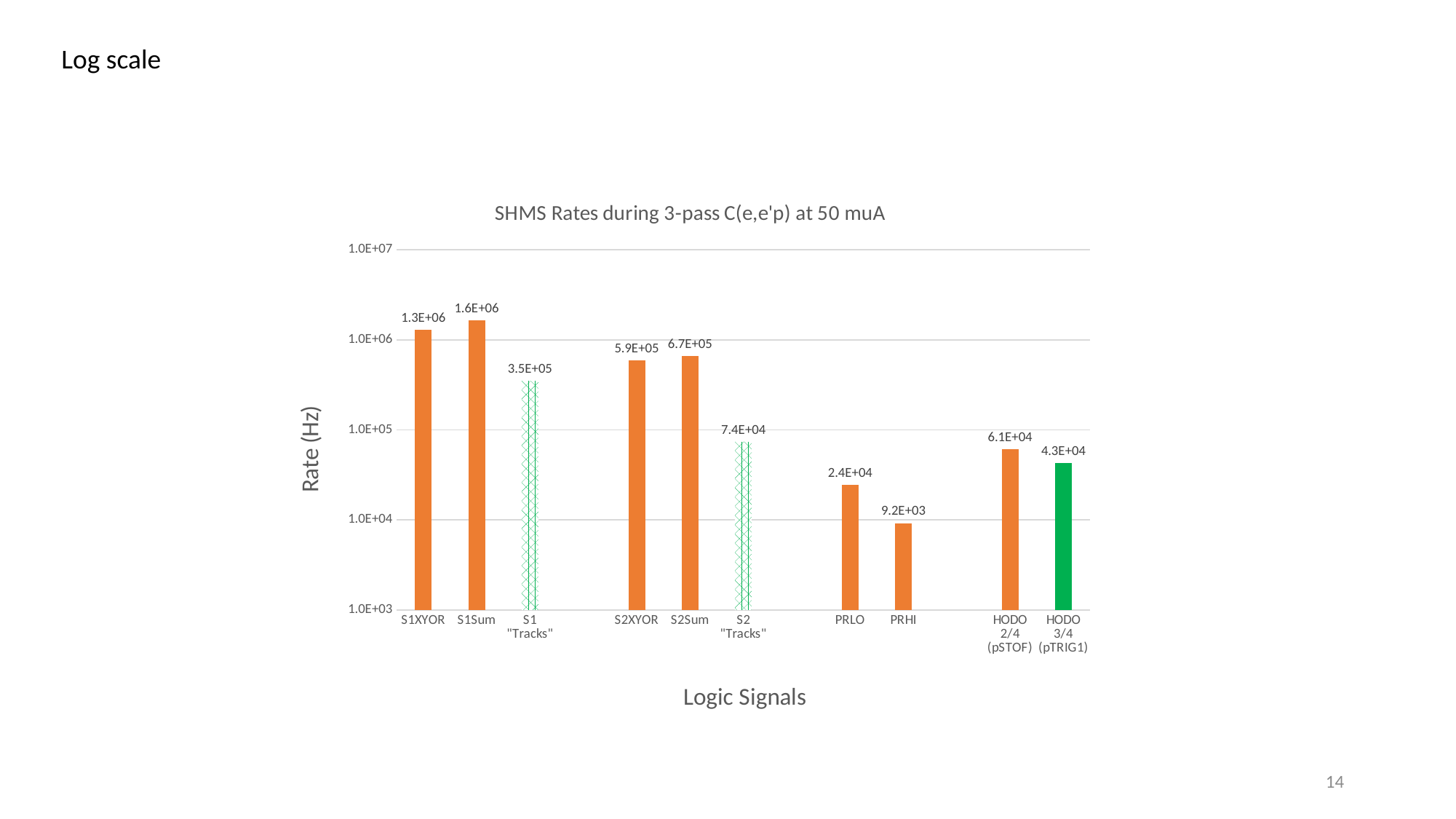
How many logic signals are plotted on the chart? 10 What is the rate for S2 "Tracks"? 7.4E+04 What is the rate for S1XYOR? 1.3E+06 What is the rate for HODO 3/4 (pTRIG1)? 4.3E+04 Which has a higher rate, S2XYOR or S2Sum? S2Sum Which has a higher rate, HODO 2/4 (pSTOF) or HODO 3/4 (pTRIG1)? HODO 2/4 (pSTOF) Which logic signal has the lowest rate? PRHI Is the value for PRHI greater or less than 1.0E+04? less What kind of chart is shown on the slide? bar chart Which logic signal has the highest rate? S1Sum What is the rate for PRLO? 2.4E+04 What is the title of the chart? SHMS Rates during 3-pass C(e,e'p) at 50 muA